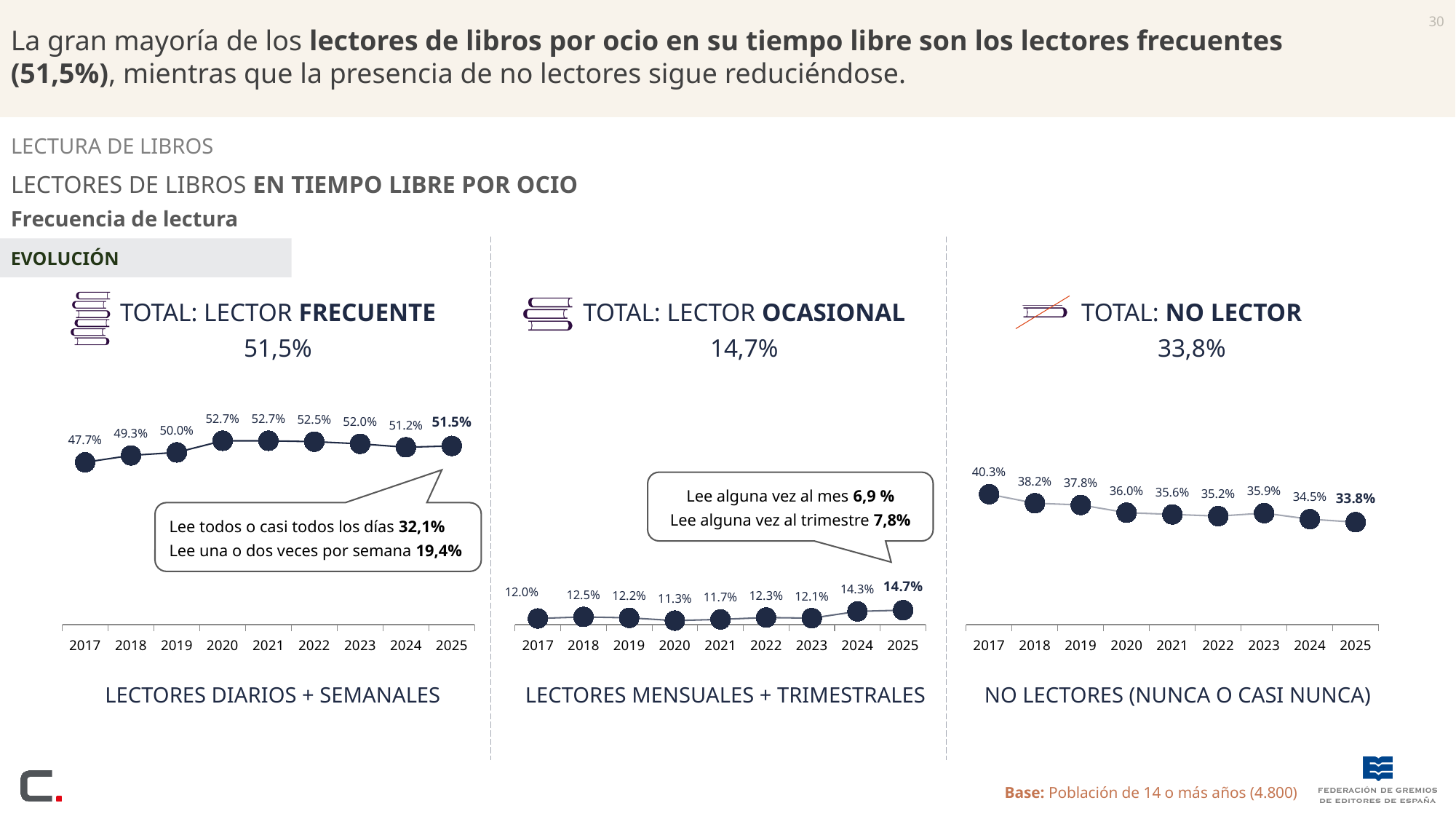
How many years are plotted in the 'TOTAL: LECTOR FRECUENTE' chart? 9 In the 'TOTAL: LECTOR OCASIONAL' chart, which year has the lowest value? 2020 In the 'TOTAL: LECTOR FRECUENTE' chart, what is the value for 2017? 47.7% In the 'TOTAL: LECTOR OCASIONAL' chart, which year has the highest value? 2025 In the 'TOTAL: NO LECTOR' chart, which year has the highest value? 2017 In the 'TOTAL: LECTOR FRECUENTE' chart, which year has the lowest value? 2017 In the 'TOTAL: NO LECTOR' chart, do the values generally rise or fall from 2017 to 2025? fall In the 'TOTAL: NO LECTOR' chart, what is the value for 2020? 36.0% In the 'TOTAL: LECTOR FRECUENTE' chart, what is the difference between the 2025 value and the 2017 value? 3.8% What kind of chart is used for 'TOTAL: NO LECTOR'? line chart In the 'TOTAL: NO LECTOR' chart, is the value for 2023 larger or smaller than the value for 2022? larger In the 'TOTAL: LECTOR OCASIONAL' chart, what is the value for 2024? 14.3%